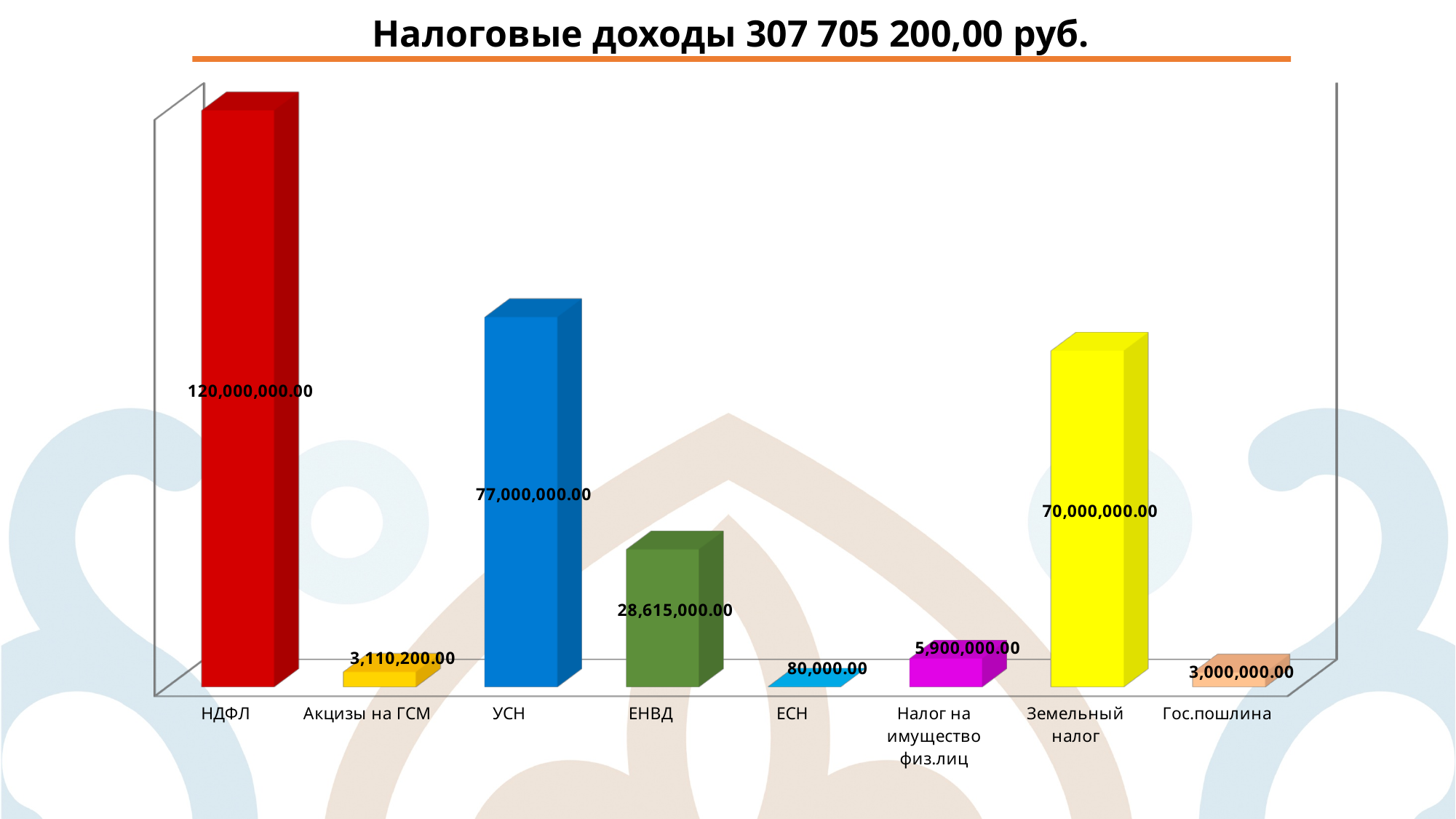
What is the value shown for НДФЛ? 120,000,000.00 Which category has the highest value? НДФЛ What is the title of the chart? Налоговые доходы 307 705 200,00 руб. What is the difference between the values for НДФЛ and УСН? 43,000,000.00 Which is larger, the value for Акцизы на ГСМ or the value for Гос.пошлина? Акцизы на ГСМ What is the value shown for Налог на имущество физ.лиц? 5,900,000.00 What is the value shown for ЕНВД? 28,615,000.00 What is the value shown for Акцизы на ГСМ? 3,110,200.00 Which category has the lowest value? ЕСН What is the difference between the values for УСН and Земельный налог? 7,000,000.00 How many categories are shown on the chart? 8 What type of chart is shown on the slide? Bar chart